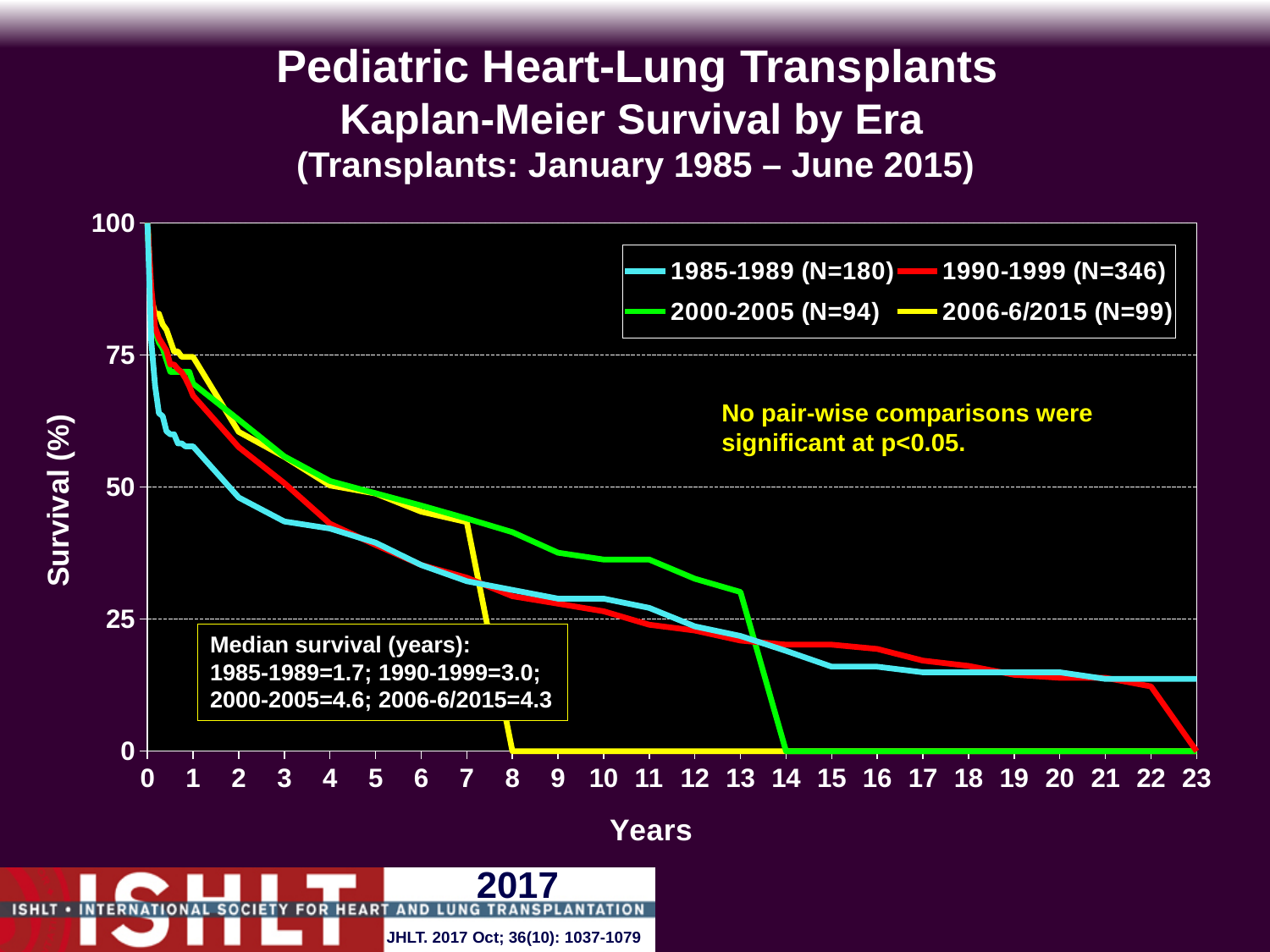
Which era has the lowest median survival? 1985-1989 How many series does the legend list? 4 Is the survival for the 1985-1989 era at year 5 greater or less than 50? less Which era has the highest median survival? 2000-2005 What is the median survival in years for the 1985-1989 era? 1.7 What kind of chart is shown on the slide? Line chart What is the median survival in years for the 2000-2005 era? 4.6 Is the survival for the 2000-2005 era at year 10 greater or less than 25? greater Do the survival curves rise or fall as years increase? Fall What is the N for the 1990-1999 era shown in the legend? 346 What is the difference in median survival (years) between the 2000-2005 era and the 1985-1989 era? 2.9 At year 12, which era has higher survival, 2000-2005 or 1985-1989? 2000-2005